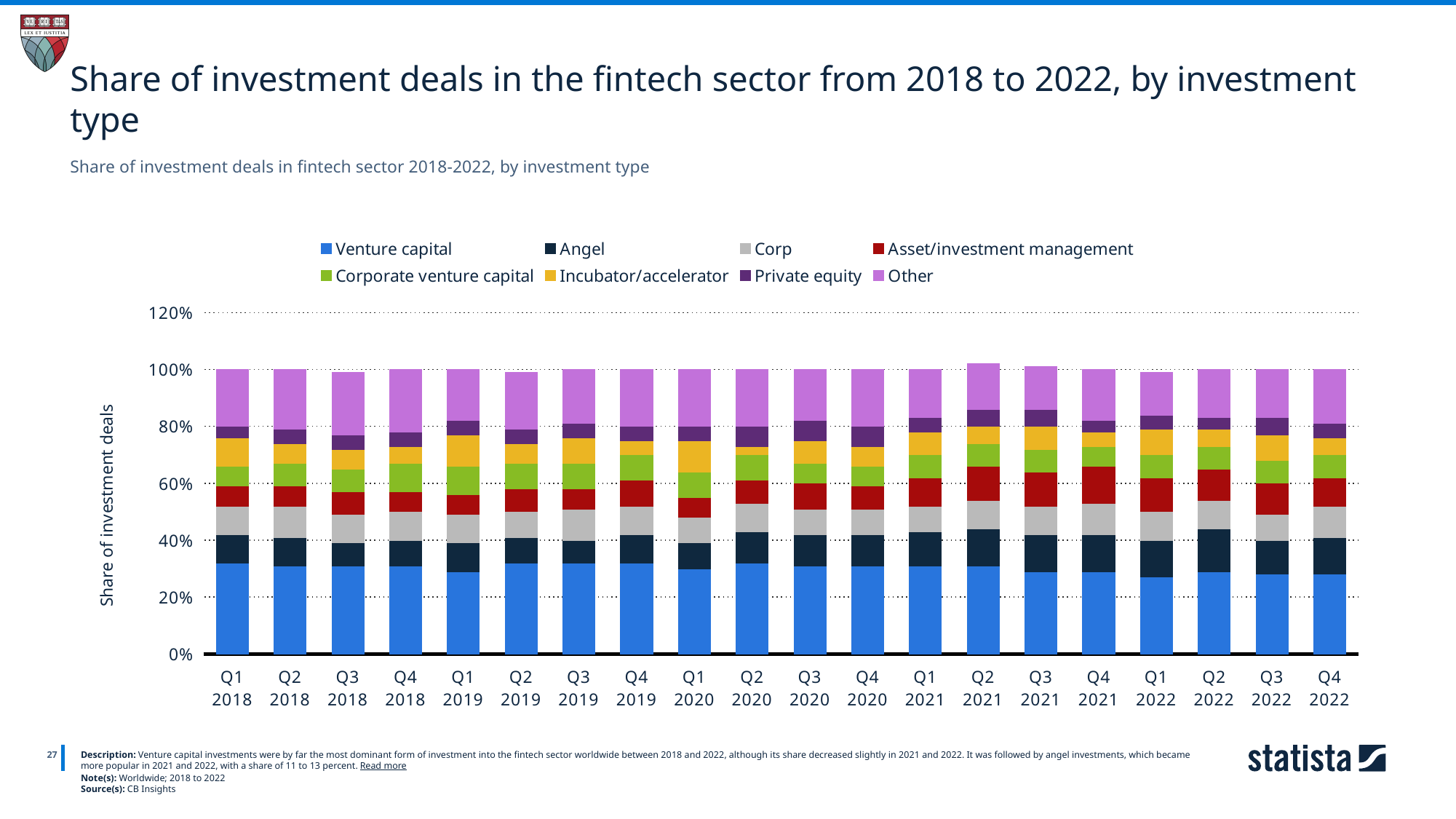
Which series forms the bottom segment of each stacked bar? Venture capital What is the first quarter shown on the x axis? Q1 2018 Is the Venture capital value for Q1 2018 greater or less than 20%? greater Which is larger in Q4 2022: the Venture capital segment or the Private equity segment? Venture capital How many quarters (bars) are plotted along the x axis? 20 Is the Venture capital value for Q1 2022 greater or less than 20%? greater How many series does the legend list? 8 Does the Venture capital share rise or fall from Q1 2018 to Q4 2022? fall Is the Venture capital value for Q4 2022 greater or less than 40%? less What is the label on the y axis? Share of investment deals What kind of chart is shown on the slide? Stacked bar chart Which is larger in Q1 2018: the Venture capital segment or the Angel segment? Venture capital